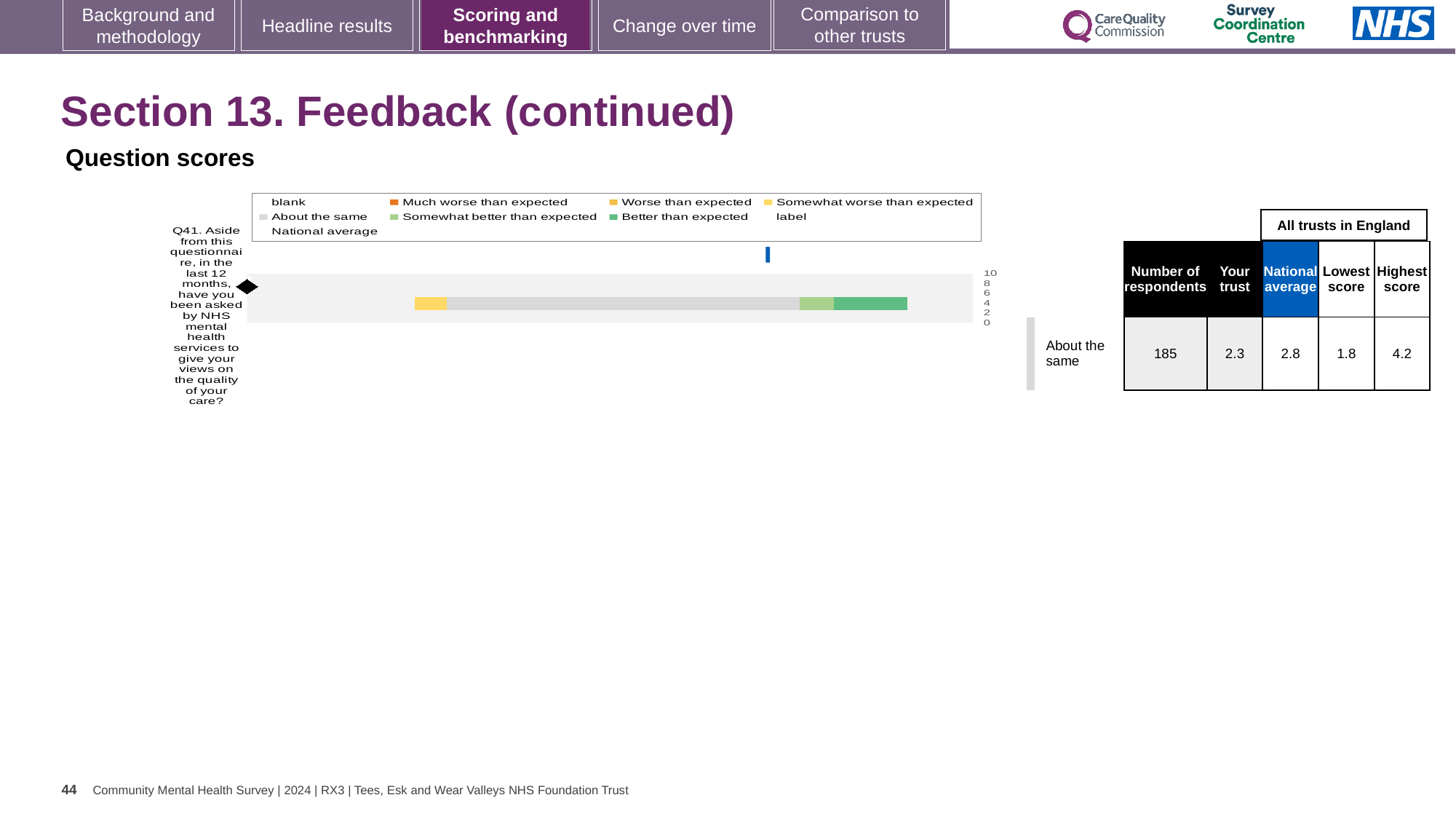
What is the national average score for Q41 shown in the table beside the chart? 2.8 What is the 'Your trust' score for Q41 shown in the table beside the chart? 2.3 What is the highest score among all trusts in England for Q41? 4.2 How many entries does the chart legend list? 9 Which is larger for Q41, the trust's score or the national average? National average How many respondents answered Q41? 185 What kind of chart is used to show the Q41 question score? bar chart Which benchmark category is the trust's Q41 score placed in? About the same What is the difference between the highest and lowest scores for Q41 across all trusts in England? 2.4 What is the difference between the national average and the trust's score for Q41? 0.5 How many questions are plotted on the chart? 1 What is the lowest score among all trusts in England for Q41? 1.8